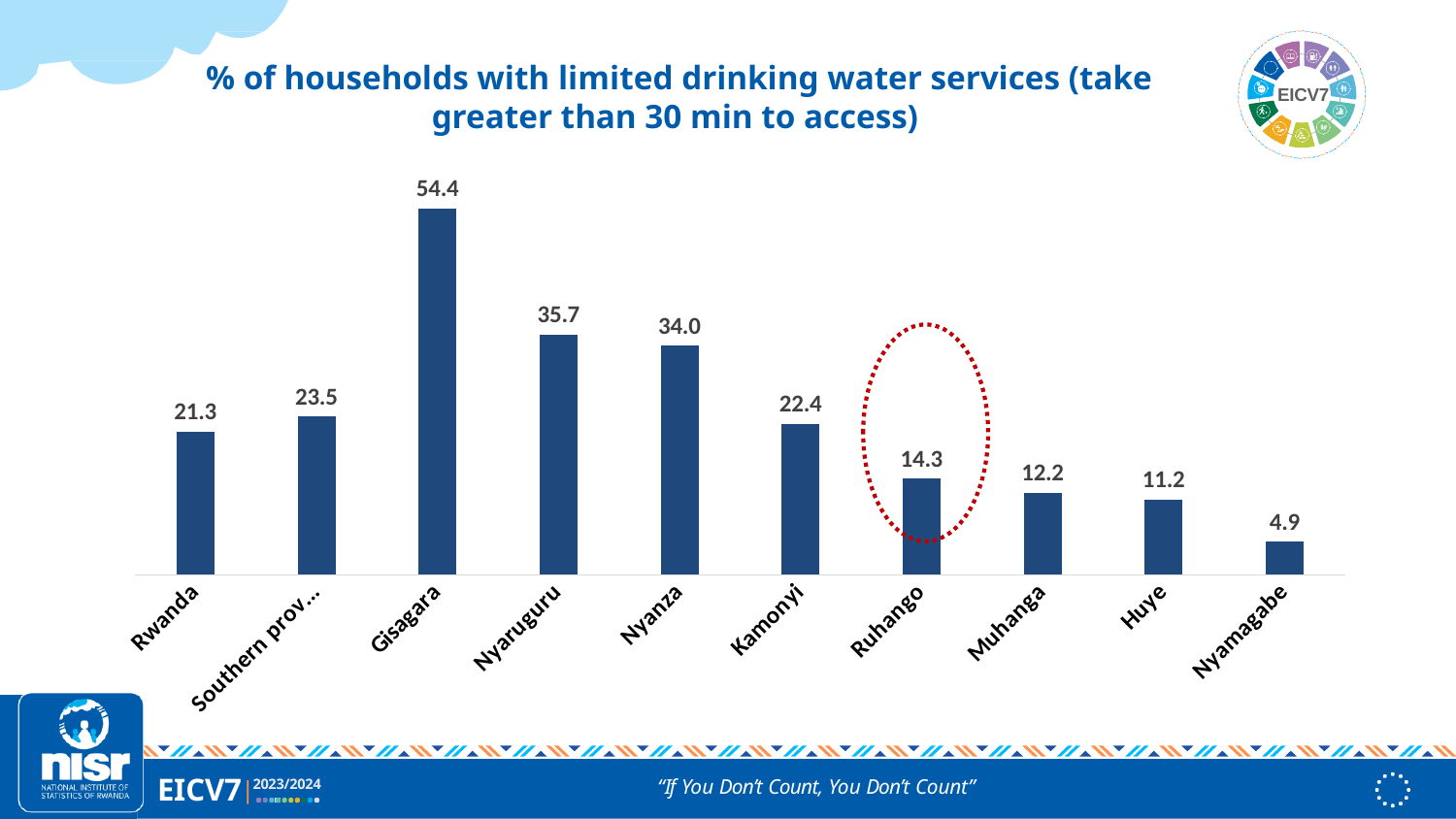
What is the value for Nyamagabe? 4.9 What is the value for Rwanda? 21.3 How many categories are shown on the x axis? 10 Which category has the highest value? Gisagara What is the value for Gisagara? 54.4 What is the difference between the values for Kamonyi and Ruhango? 8.1 Which category is highlighted with a red dotted circle? Ruhango Which category has the lowest value? Nyamagabe Which is larger, the value for Nyaruguru or the value for Nyanza? Nyaruguru What kind of chart is shown on the slide? Bar chart What is the value for Ruhango? 14.3 What is the difference between the values for Gisagara and Nyaruguru? 18.7